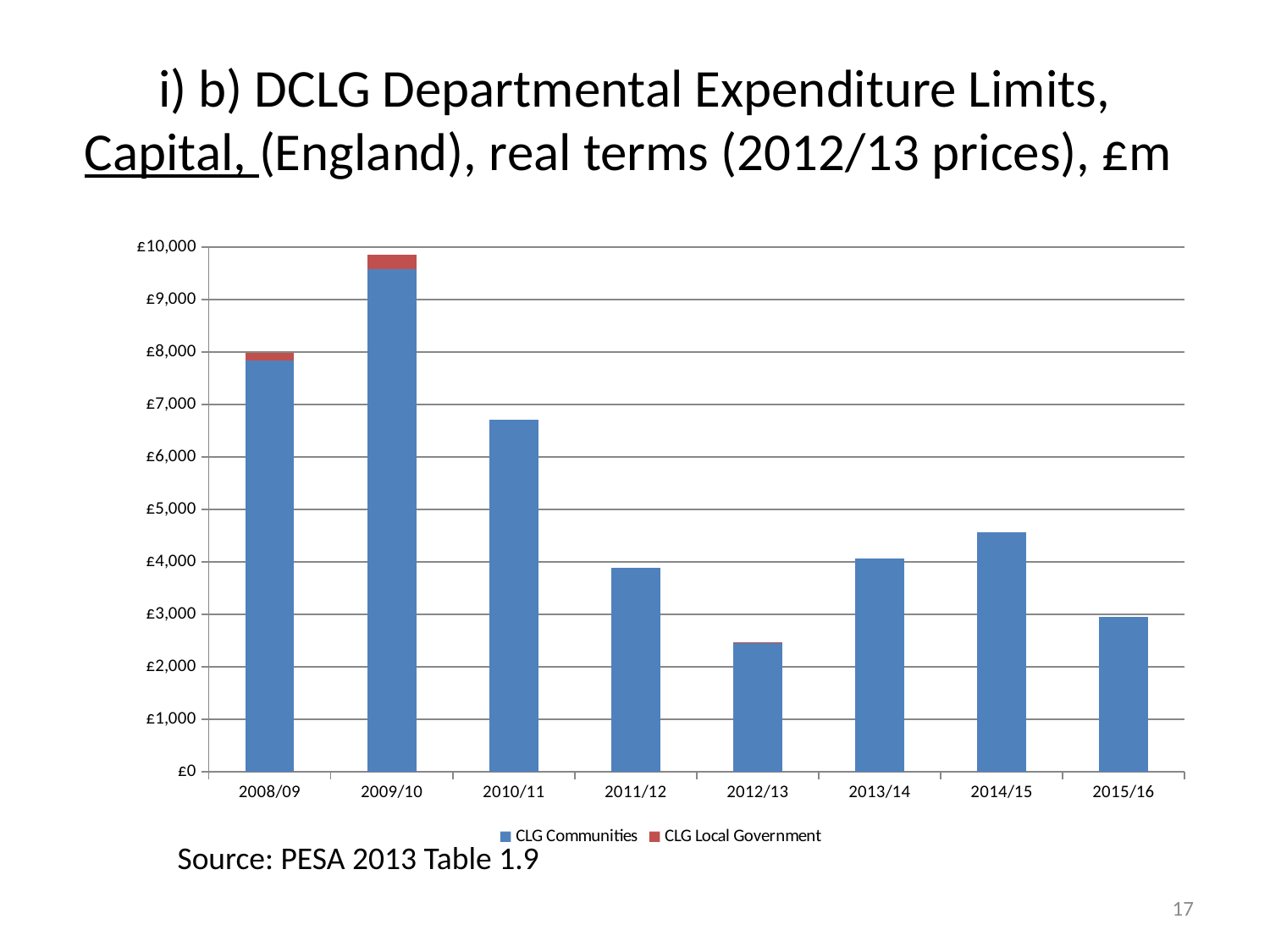
Is the total value for 2009/10 greater or less than £9,000? greater Is the value for 2010/11 greater or less than £6,000? greater Which year has the highest total capital expenditure limit? 2009/10 What kind of chart is shown on the slide? Bar chart Which is larger, the value for 2010/11 or the value for 2011/12? 2010/11 Which series is shown in red in the legend? CLG Local Government How many financial years are shown on the x axis? 8 Do the values rise or fall from 2009/10 to 2012/13? Fall How many series does the legend list? 2 Is the value for 2012/13 greater or less than £3,000? less Which is larger, the value for 2014/15 or the value for 2013/14? 2014/15 Which year has the lowest total capital expenditure limit? 2012/13